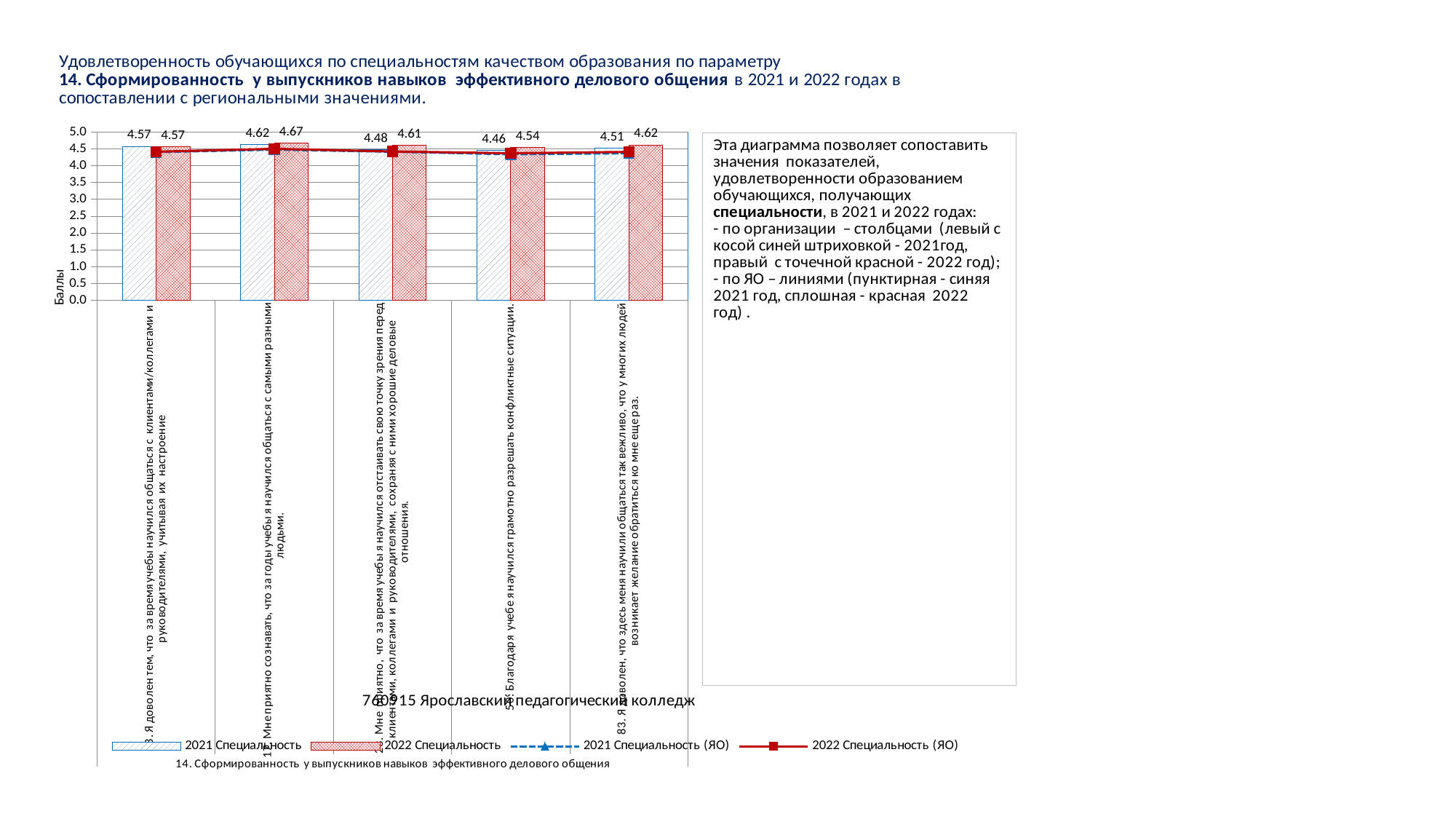
How many series does the chart legend list? 4 How many categories are shown on the x axis of the chart? 5 Which category has the lowest 2021 Специальность value? The fourth category (Благодаря учебе я научился грамотно разрешать конфликтные ситуации), 4.46 Is the 2022 Специальность (ЯО) line value for the first category greater or less than 4.0? greater For the third category (about отстаивать свою точку зрения), what is the difference between the 2022 and 2021 Специальность values? 0.13 For the last category (83. Я доволен, что здесь меня научили общаться так вежливо...), which is larger: the 2021 Специальность value or the 2022 Специальность value? 2022 Специальность (4.62) For the fourth category (Благодаря учебе я научился грамотно разрешать конфликтные ситуации), what is the difference between the 2022 and 2021 Специальность values? 0.08 What is the title of the vertical axis of the chart? Баллы What is the 2021 Специальность value for the last category (83. Я доволен, что здесь меня научили общаться так вежливо...)? 4.51 What is the 2022 Специальность value for the second category (Мне приятно сознавать, что за годы учебы я научился общаться с самыми разными людьми)? 4.67 Which category has the highest 2022 Специальность value? The second category (Мне приятно сознавать, что за годы учебы я научился общаться с самыми разными людьми), 4.67 What is the 2021 Специальность value for the first category (3. Я доволен тем, что за время учебы научился общаться с клиентами/коллегами и руководителями...)? 4.57